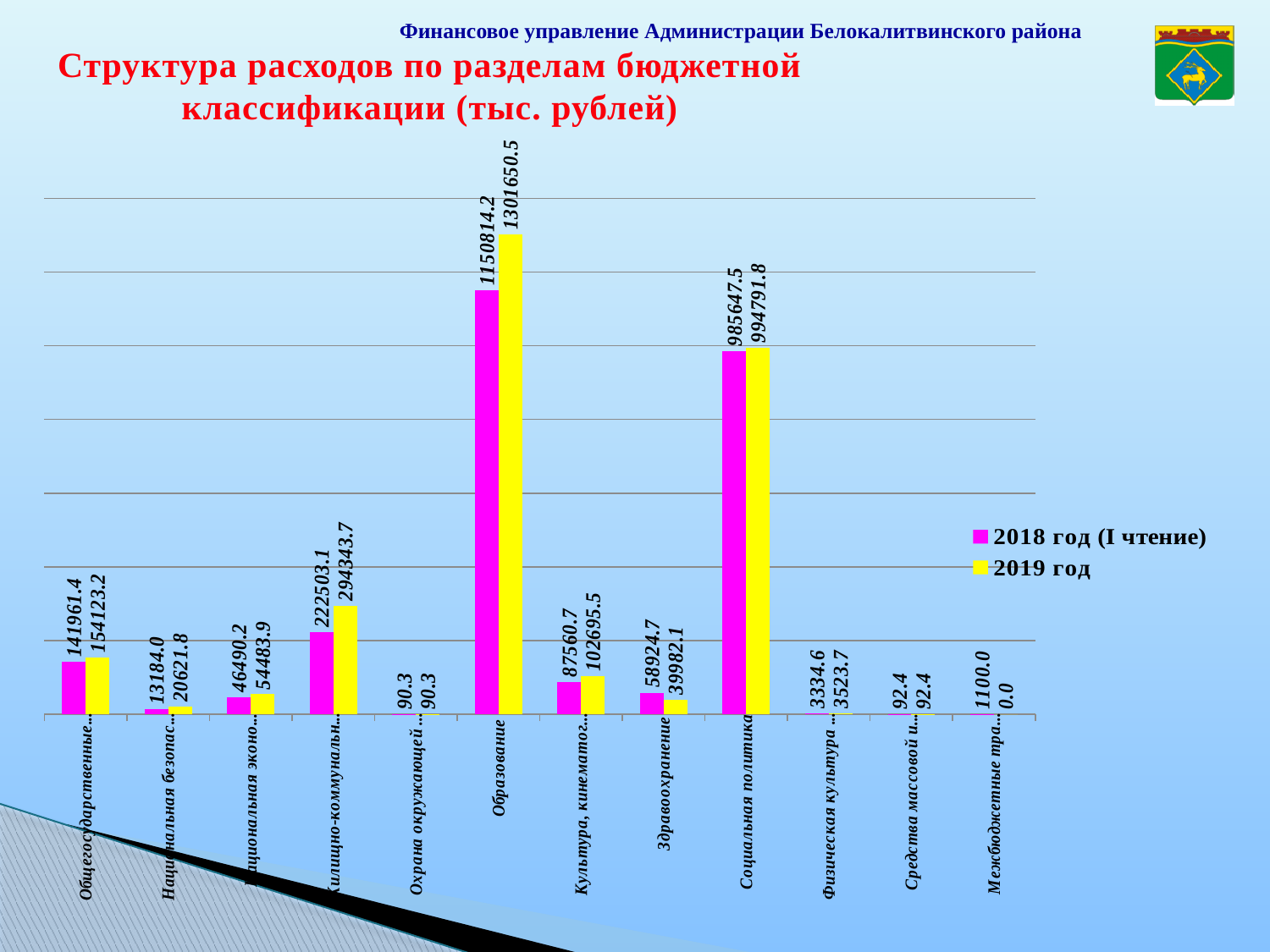
Which colour represents the 2019 год series in the chart? yellow What is the value for Социальная политика in the 2019 год series? 994791.8 What is the value for Образование in the 2019 год series? 1301650.5 What type of chart is shown on the slide? bar chart How many series does the legend list? 2 What is the value for Здравоохранение in the 2018 год (I чтение) series? 58924.7 How many categories are shown on the x axis? 12 For Здравоохранение, which series has the larger value: 2018 год (I чтение) or 2019 год? 2018 год (I чтение) Which category has the lowest value in the 2019 год series? Межбюджетные трансферты Which category has the highest value in the 2019 год series? Образование What is the difference between the 2018 год (I чтение) and 2019 год values for Здравоохранение? 18942.6 What is the difference between the 2019 год and 2018 год (I чтение) values for Образование? 150836.3